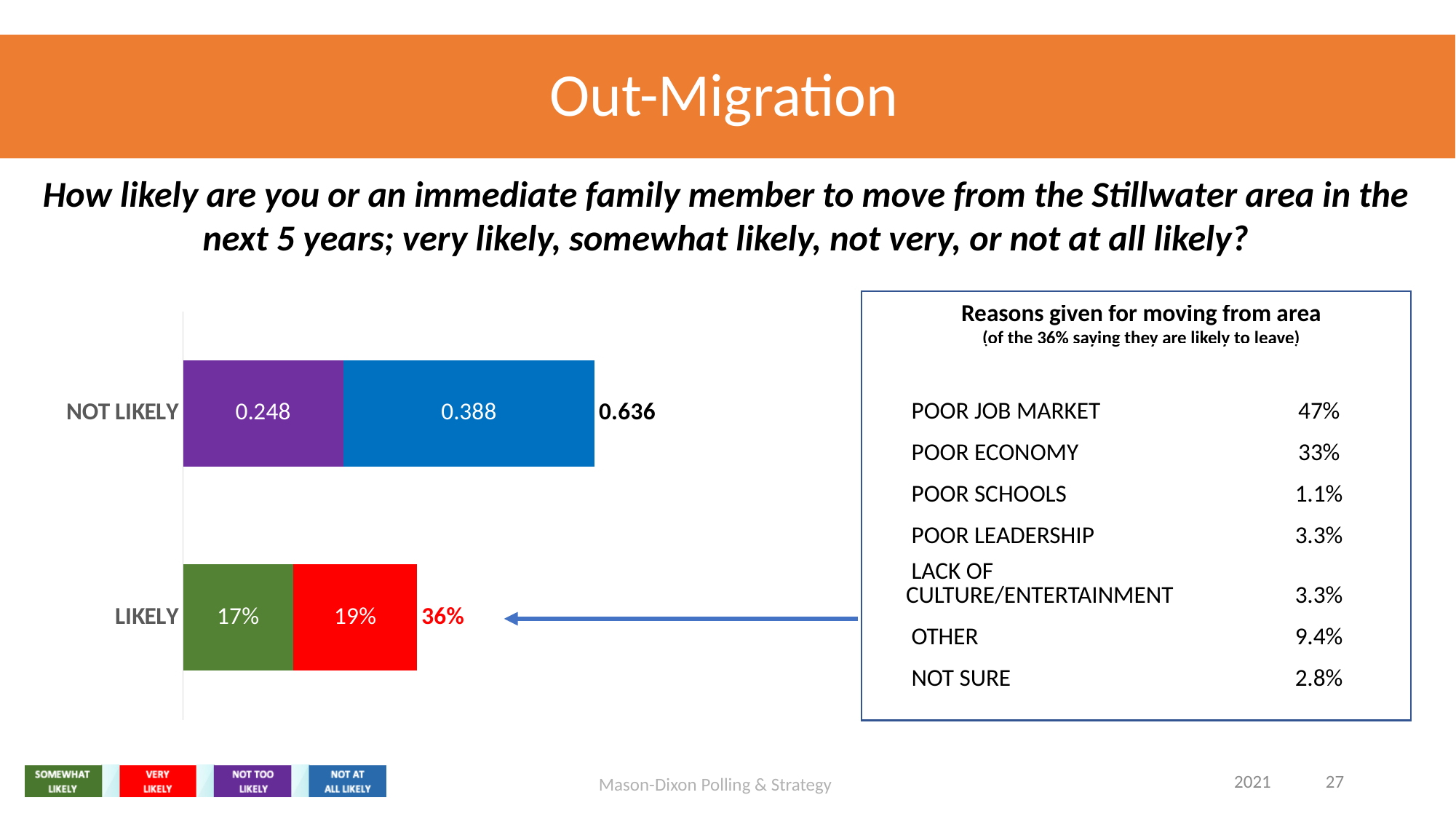
How many categories does the bar chart show? 2 What is the value of the Very Likely segment in the LIKELY bar? 19% What is the value of the Not Too Likely segment in the NOT LIKELY bar? 0.248 What kind of chart is shown on the slide? Stacked bar chart How many series does the legend list? 4 Which category has the longer bar, NOT LIKELY or LIKELY? NOT LIKELY Which series is shown in red in the legend? Very Likely What is the total shown for the NOT LIKELY bar? 0.636 What is the total shown for the LIKELY bar? 36% What is the value of the Not At All Likely segment in the NOT LIKELY bar? 0.388 Within the NOT LIKELY bar, which segment is larger, Not Too Likely or Not At All Likely? Not At All Likely What is the value of the Somewhat Likely segment in the LIKELY bar? 17%